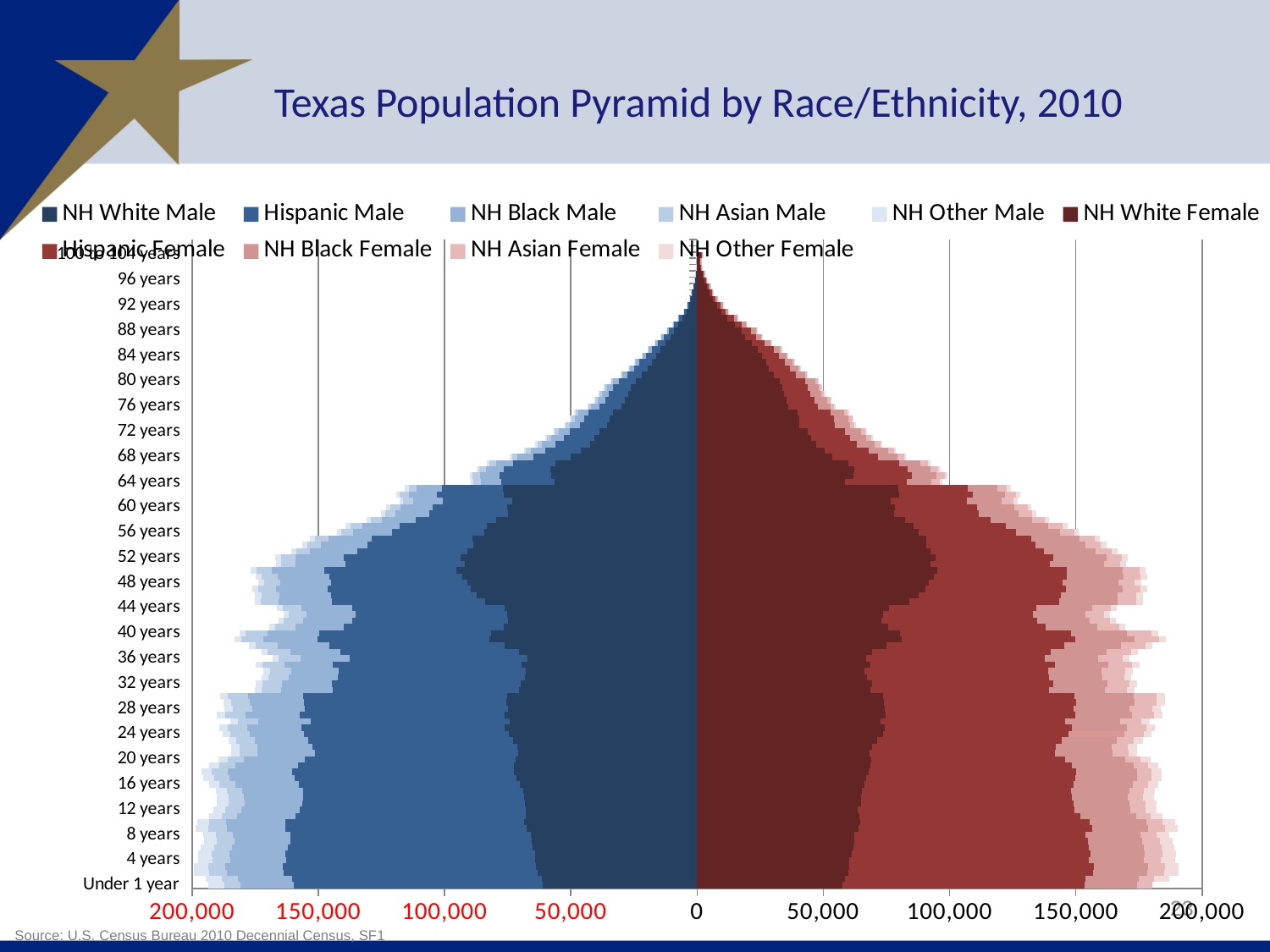
What is the title of the chart? Texas Population Pyramid by Race/Ethnicity, 2010 Which is larger at 84 years: the total male population (left side) or the total female population (right side)? Female As age increases from Under 1 year to 100 to 104 years, do the bars generally get longer or shorter? shorter Is the NH White Female segment at 48 years greater or less than 50,000? greater Is the total male population (left side) for Under 1 year greater or less than 150,000? greater What kind of chart is shown on the slide? Bar chart (population pyramid) Is the NH White Male segment at 48 years greater or less than 50,000? greater Which legend entry is listed first? NH White Male How many series does the legend list? 10